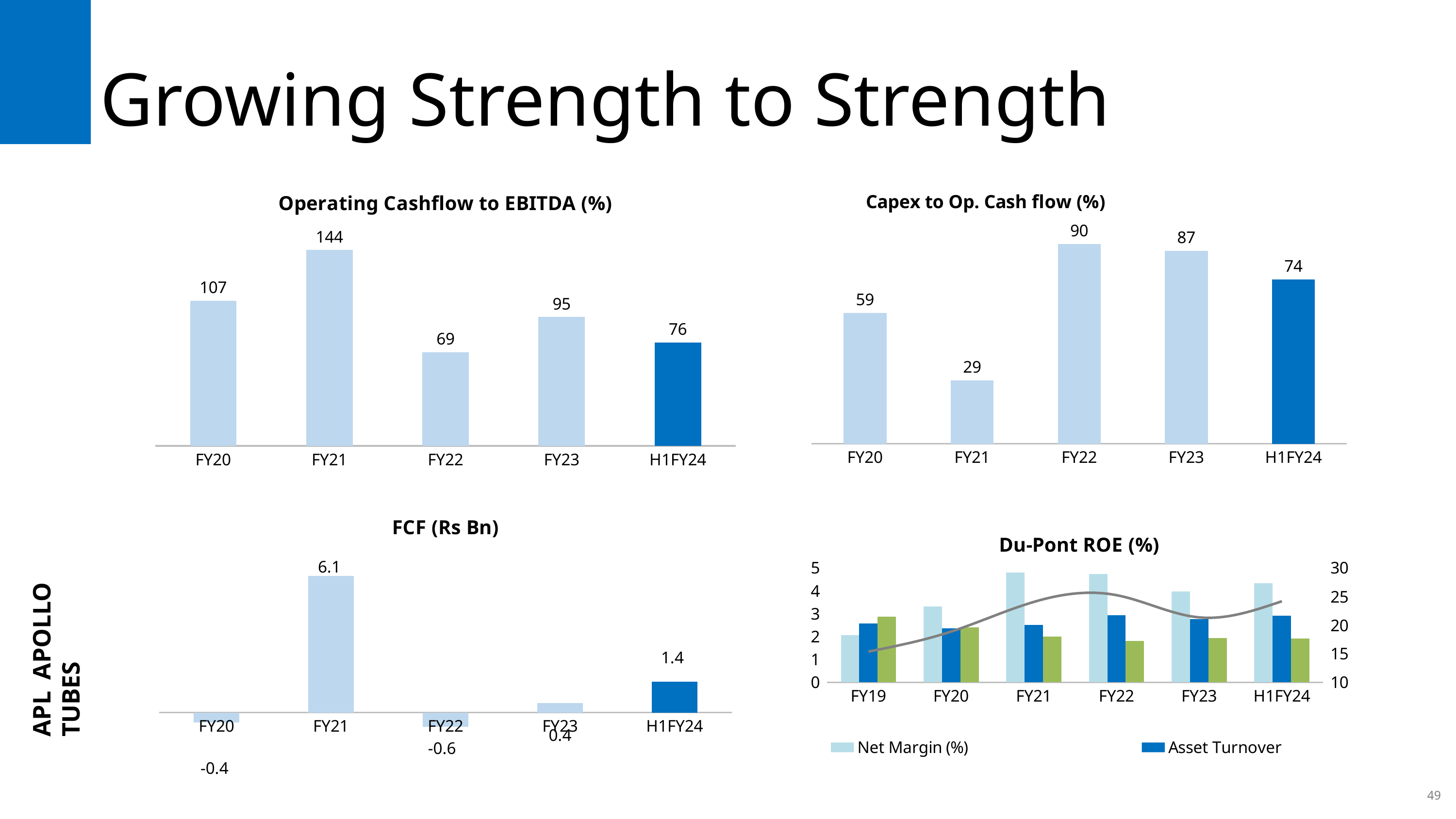
In the Du-Pont ROE (%) chart, is the Net Margin (%) value for FY21 greater or less than 4 on the left axis? greater In the Operating Cashflow to EBITDA (%) chart, which period has the lowest value? FY22 In the Capex to Op. Cash flow (%) chart, which period has the highest value? FY22 In the Operating Cashflow to EBITDA (%) chart, what is the difference between FY21 and FY22? 75 What type of chart is the Capex to Op. Cash flow (%) chart? Bar chart In the FCF (Rs Bn) chart, what is the value for FY21? 6.1 In the Capex to Op. Cash flow (%) chart, is the value for FY20 or H1FY24 larger? H1FY24 In the Operating Cashflow to EBITDA (%) chart, what is the value for FY21? 144 How many periods are shown on the x axis of the Du-Pont ROE (%) chart? 6 In the Capex to Op. Cash flow (%) chart, what is the value for FY21? 29 In the FCF (Rs Bn) chart, what is the value for FY22? -0.6 How many periods are shown on the x axis of the FCF (Rs Bn) chart? 5